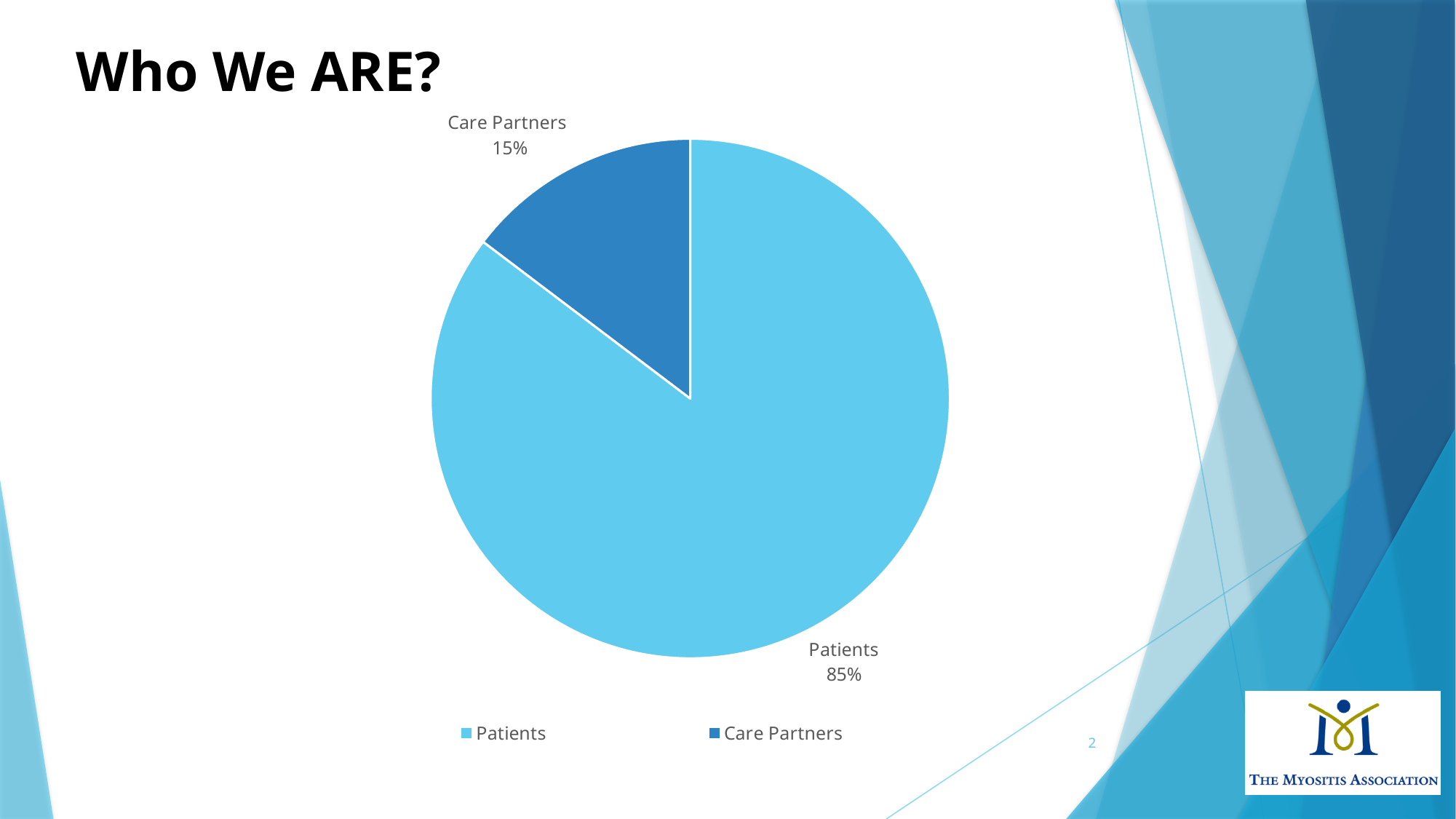
Is the share for Care Partners greater or less than 50%? less Which legend entry is shown in the darker blue colour? Care Partners How many entries does the legend list? 2 What kind of chart is shown on the slide? pie chart Which category has the smallest slice of the pie? Care Partners What share of the pie is Patients? 85% What share of the pie is Care Partners? 15% What is the difference in percentage points between the Patients slice and the Care Partners slice? 70 How many slices does the pie chart have? 2 Which slice is larger, Patients or Care Partners? Patients Which category has the largest slice of the pie? Patients What is the title of the slide containing the pie chart? Who We ARE?